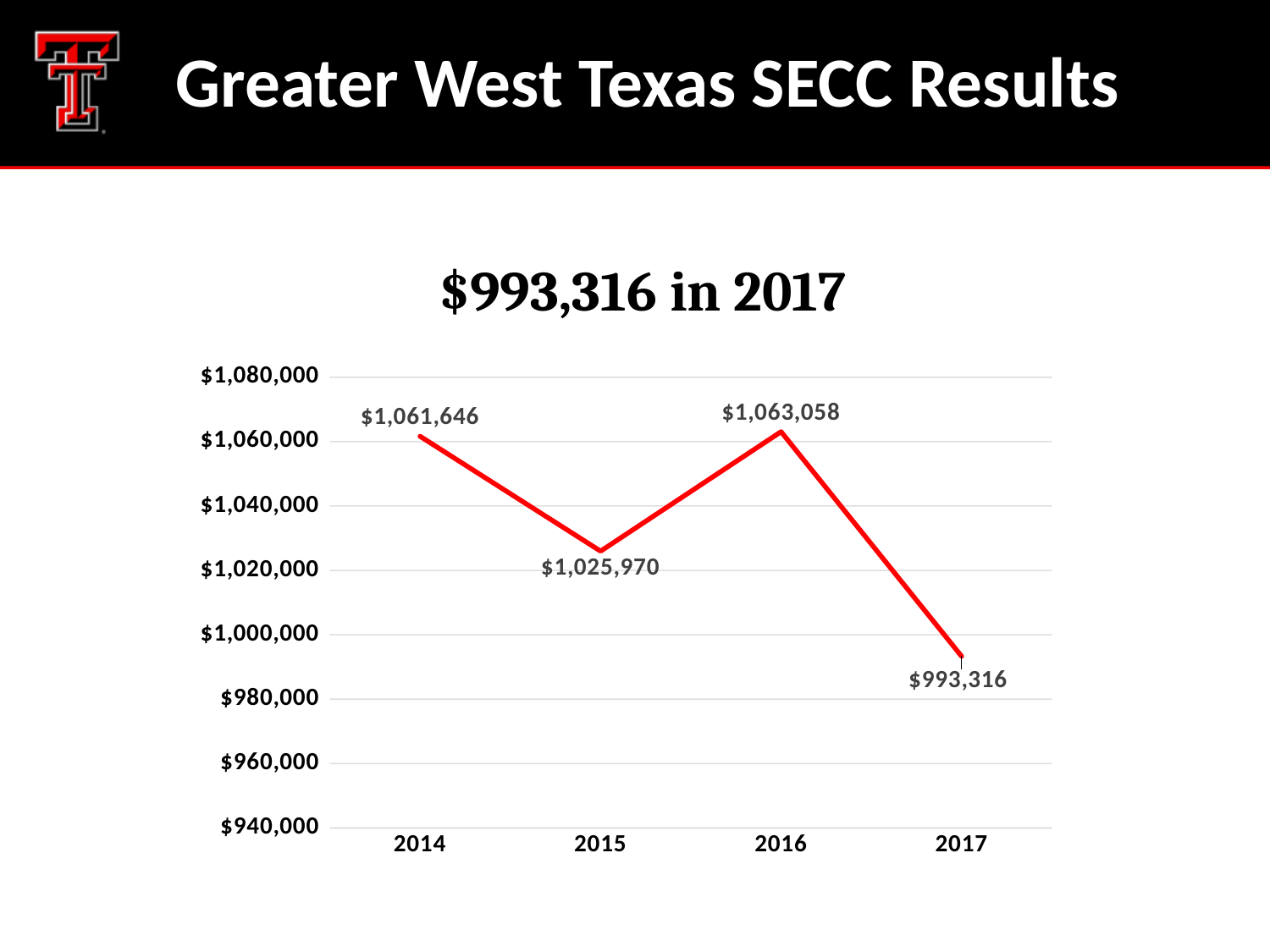
Is the value for 2017 greater or less than $1,000,000? less What was the Greater West Texas SECC result in 2017? $993,316 What is the difference between the 2014 value and the 2015 value? $35,676 What was the value for 2015? $1,025,970 What is the difference between the 2016 value and the 2017 value? $69,742 What was the value for 2016? $1,063,058 Which year had the highest value? 2016 What kind of chart is shown on the slide? line chart Which is larger, the value for 2014 or the value for 2015? 2014 How many years are plotted on the chart? 4 Which year had the lowest value? 2017 What was the value for 2014? $1,061,646